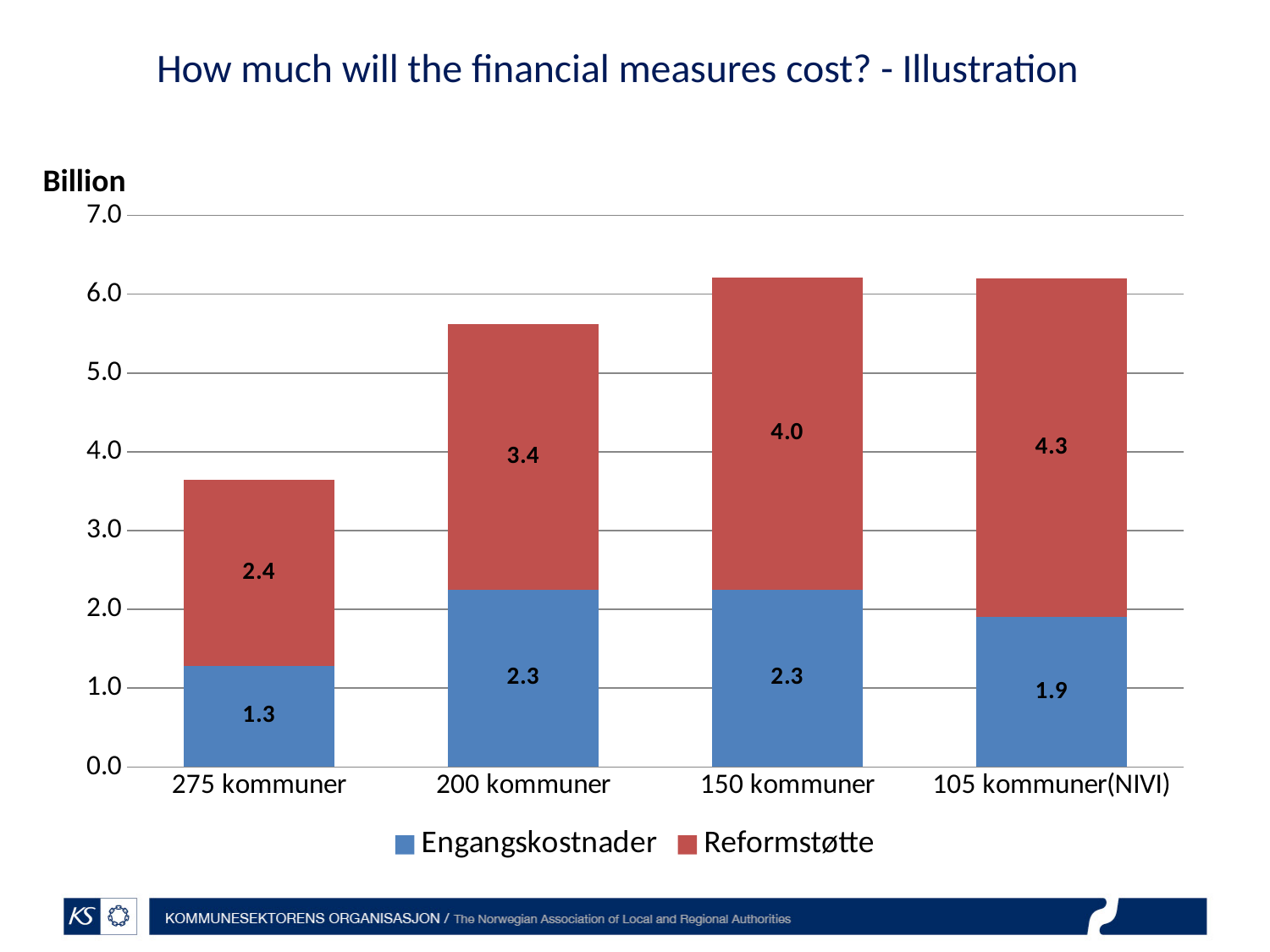
Is the total stacked bar for 200 kommuner greater or less than 5.0? greater Which category has the highest Reformstøtte value? 105 kommuner(NIVI) What is the Engangskostnader value for 275 kommuner? 1.3 Which category has the lowest Engangskostnader value? 275 kommuner How many series does the legend list? 2 What kind of chart is shown on the slide? Stacked bar chart What is the total of the stacked bar for 275 kommuner? 3.7 What is the difference between the Reformstøtte values for 105 kommuner(NIVI) and 275 kommuner? 1.9 How many categories are shown on the x axis? 4 What is the Engangskostnader value for 105 kommuner(NIVI)? 1.9 What is the Reformstøtte value for 150 kommuner? 4.0 Which is larger: the Reformstøtte value for 200 kommuner or for 150 kommuner? 150 kommuner